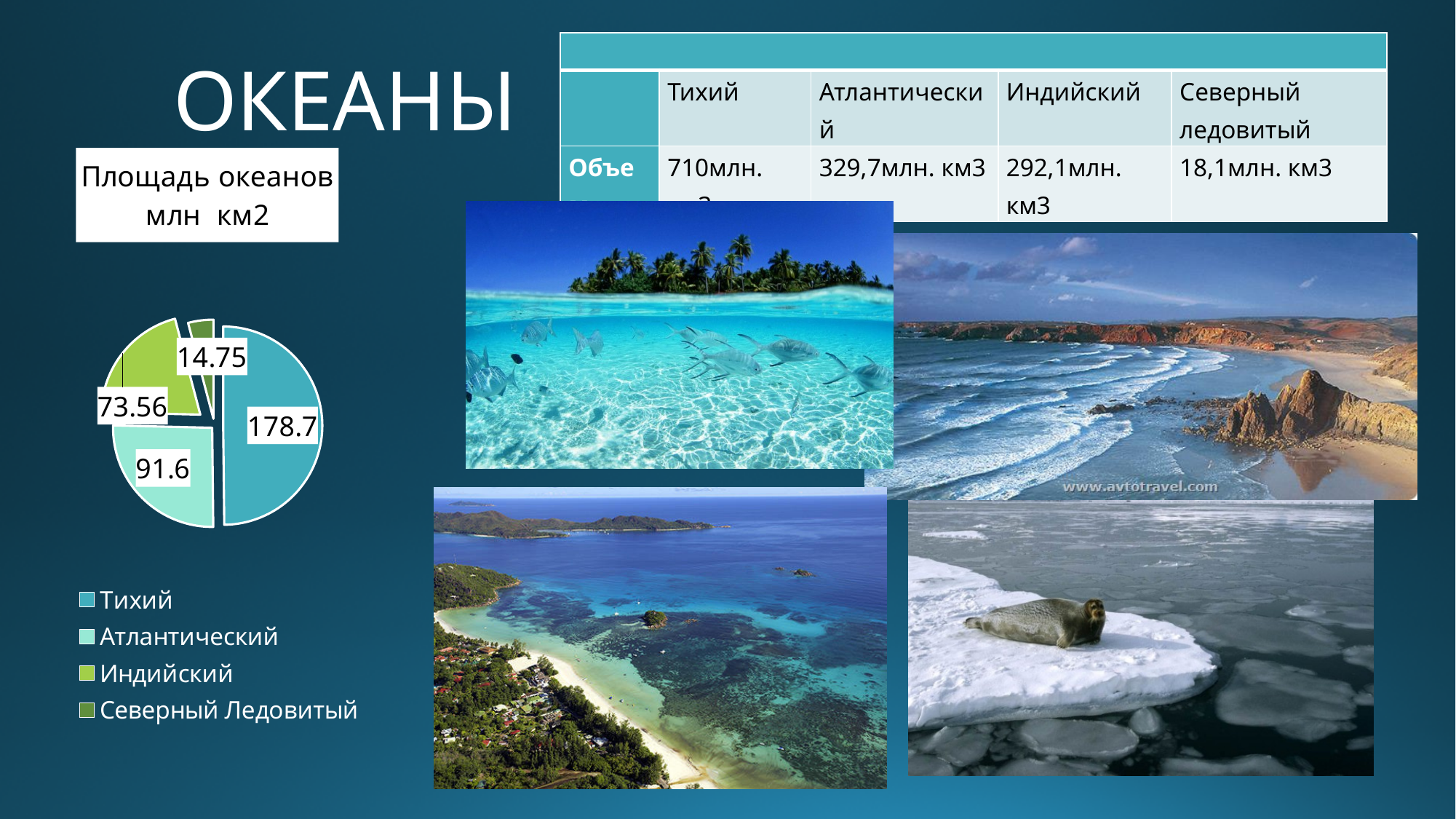
What type of chart is shown on the slide? pie chart What is the value for Индийский in the pie chart? 73.56 What is the value for Атлантический in the pie chart? 91.6 What is the value for Тихий in the pie chart? 178.7 Which ocean has the smallest slice in the pie chart? Северный Ледовитый What is the title of the pie chart? Площадь океанов млн км2 How many slices does the pie chart have? 4 Which ocean has the largest slice in the pie chart? Тихий What is the difference between the values for Тихий and Атлантический in the pie chart? 87.1 Which is larger in the pie chart, Атлантический or Индийский? Атлантический What is the value for Северный Ледовитый in the pie chart? 14.75 How many entries does the pie chart legend list? 4